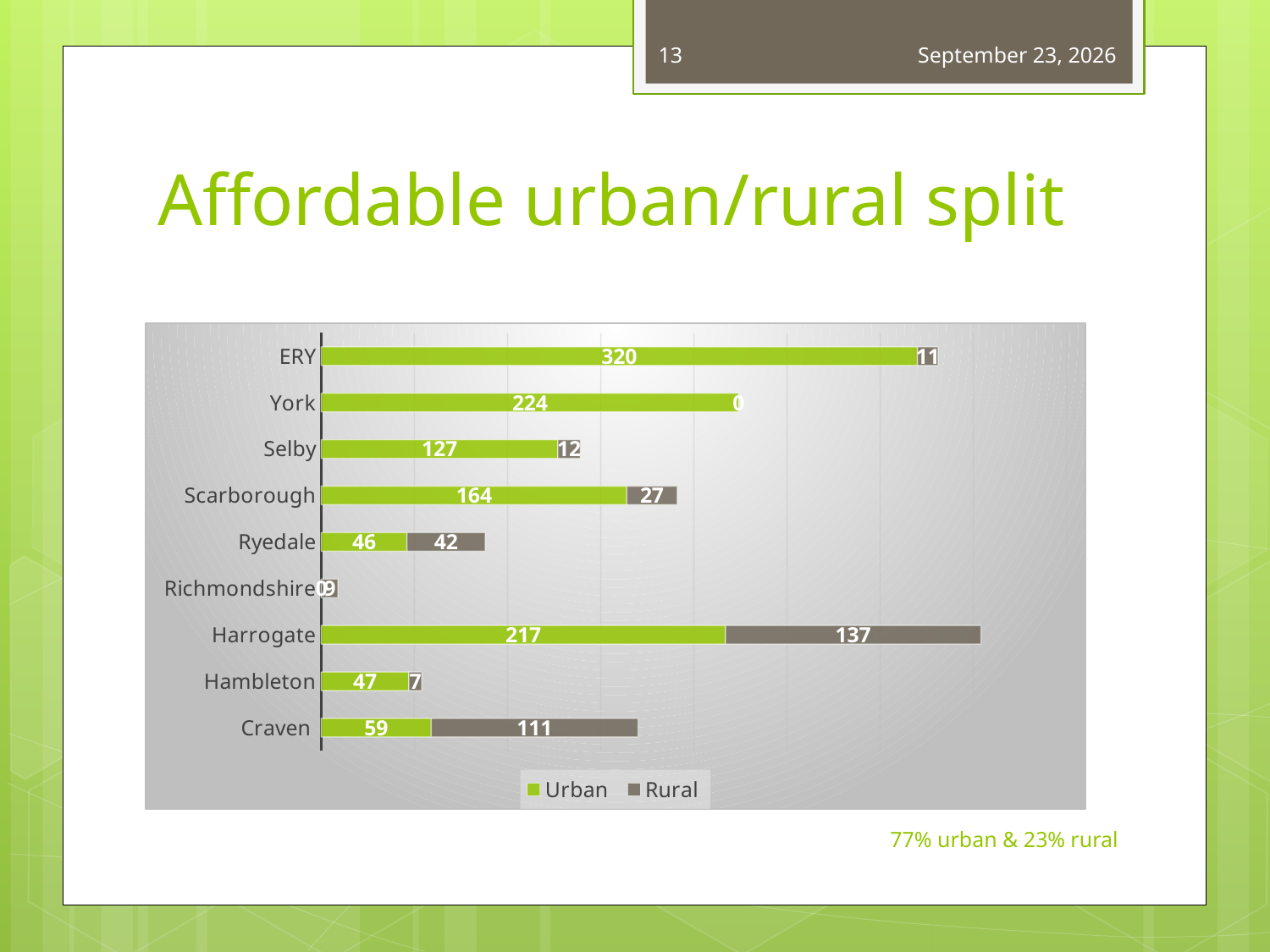
Which is larger for Craven, the Urban value or the Rural value? Rural What is the difference between the Urban and Rural values for Harrogate? 80 Which category has the highest Rural value? Harrogate What kind of chart is shown on the slide? Stacked bar chart What is the Urban value for ERY? 320 What is the total of the stacked bar for Scarborough? 191 What is the Urban value for Scarborough? 164 What is the Rural value for Craven? 111 How many series does the legend list? 2 Which category has the highest Urban value? ERY How many categories are shown on the chart? 9 What is the Rural value for Harrogate? 137